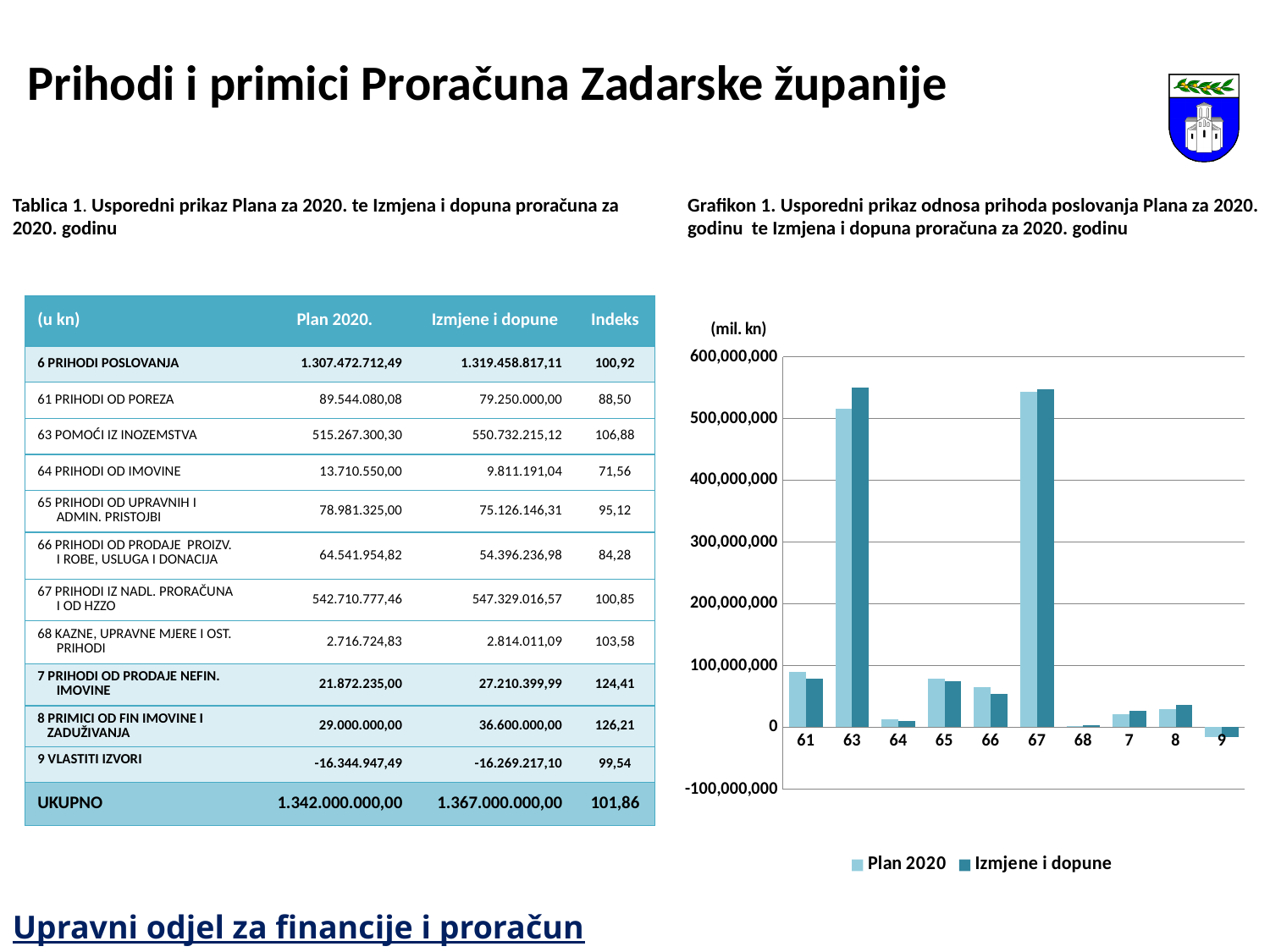
In Grafikon 1, for category 8, which series has the larger value: Plan 2020 or Izmjene i dopune? Izmjene i dopune How many series does the legend of Grafikon 1 list? 2 In Grafikon 1, for category 61, which series has the larger value: Plan 2020 or Izmjene i dopune? Plan 2020 In Grafikon 1, is the Izmjene i dopune value for category 63 greater or less than 500,000,000? greater In Grafikon 1, is the Plan 2020 value for category 65 greater or less than 100,000,000? less In Grafikon 1, is the Plan 2020 value for category 67 greater or less than 500,000,000? greater What unit label is shown above the y axis of Grafikon 1? (mil. kn) In Grafikon 1, which category has the lowest value for the Plan 2020 series? 9 How many categories are shown on the x axis of Grafikon 1? 10 What kind of chart is Grafikon 1? bar chart In Grafikon 1, which category has the lowest value for the Izmjene i dopune series? 9 In Grafikon 1, for category 63, which series has the larger value: Plan 2020 or Izmjene i dopune? Izmjene i dopune